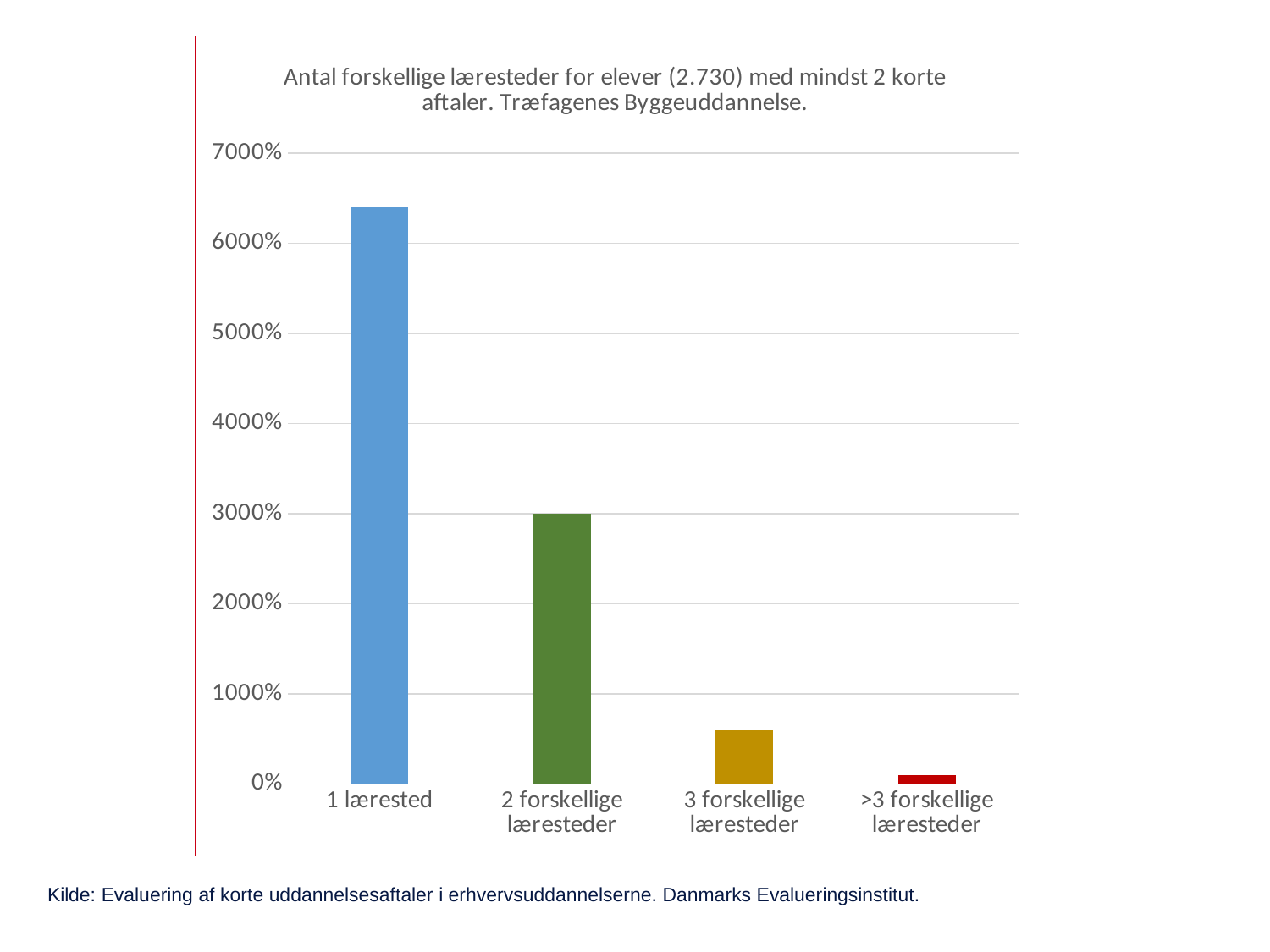
Is the value for 1 lærested greater or less than 6000%? greater What kind of chart is shown on the slide? bar chart How many categories are shown on the x axis of the chart? 4 Is the value for 3 forskellige læresteder greater or less than 1000%? less Which category has the highest value in the chart? 1 lærested Which is larger, the value for 2 forskellige læresteder or the value for 3 forskellige læresteder? 2 forskellige læresteder What is the title of the chart? Antal forskellige læresteder for elever (2.730) med mindst 2 korte aftaler. Træfagenes Byggeuddannelse. Do the values rise or fall moving from left to right along the x axis? fall Is the value for >3 forskellige læresteder greater or less than 1000%? less Which category has the lowest value in the chart? >3 forskellige læresteder What colour is the bar for 1 lærested? blue